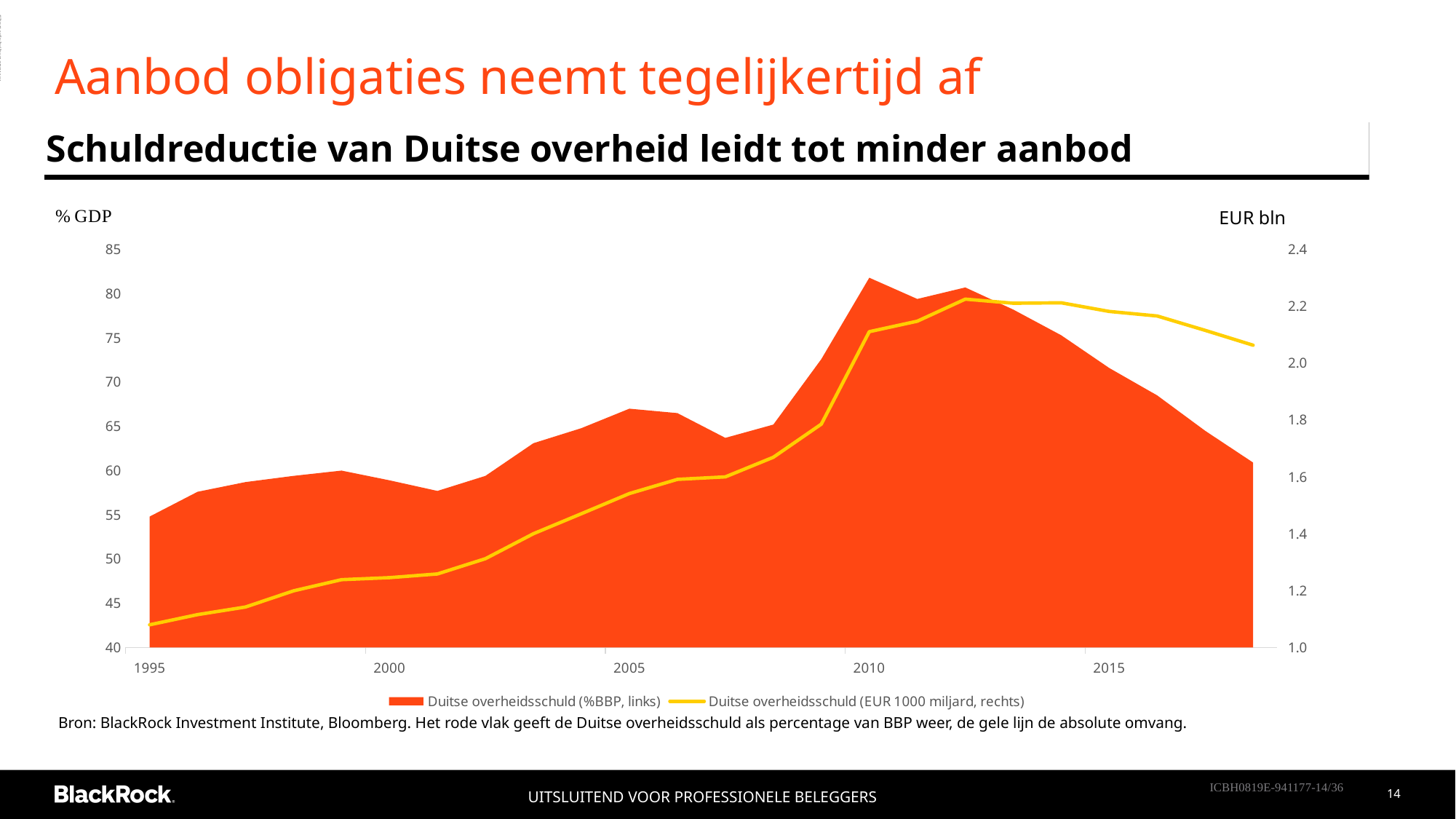
In which year is the yellow line (Duitse overheidsschuld, EUR 1000 miljard) at its lowest value? 1995 What kind of chart is shown on the slide? An area chart with a line series Does the red area (Duitse overheidsschuld, %BBP) rise or fall between 2010 and the end of the series? fall Is the value of the yellow line (Duitse overheidsschuld, EUR 1000 miljard) in 2010 greater or less than 2.0? greater How many series does the chart legend list? 2 Around which year does the red area (Duitse overheidsschuld, %BBP) reach its highest value? 2010 What is the label of the right-hand vertical axis? EUR bln Is the value of the red area (Duitse overheidsschuld, %BBP) in 2010 greater or less than 75? greater Is the value of the yellow line (Duitse overheidsschuld, EUR 1000 miljard) in 1995 greater or less than 1.2? less Does the yellow line (Duitse overheidsschuld, EUR 1000 miljard) rise or fall between 1995 and 2010? rise